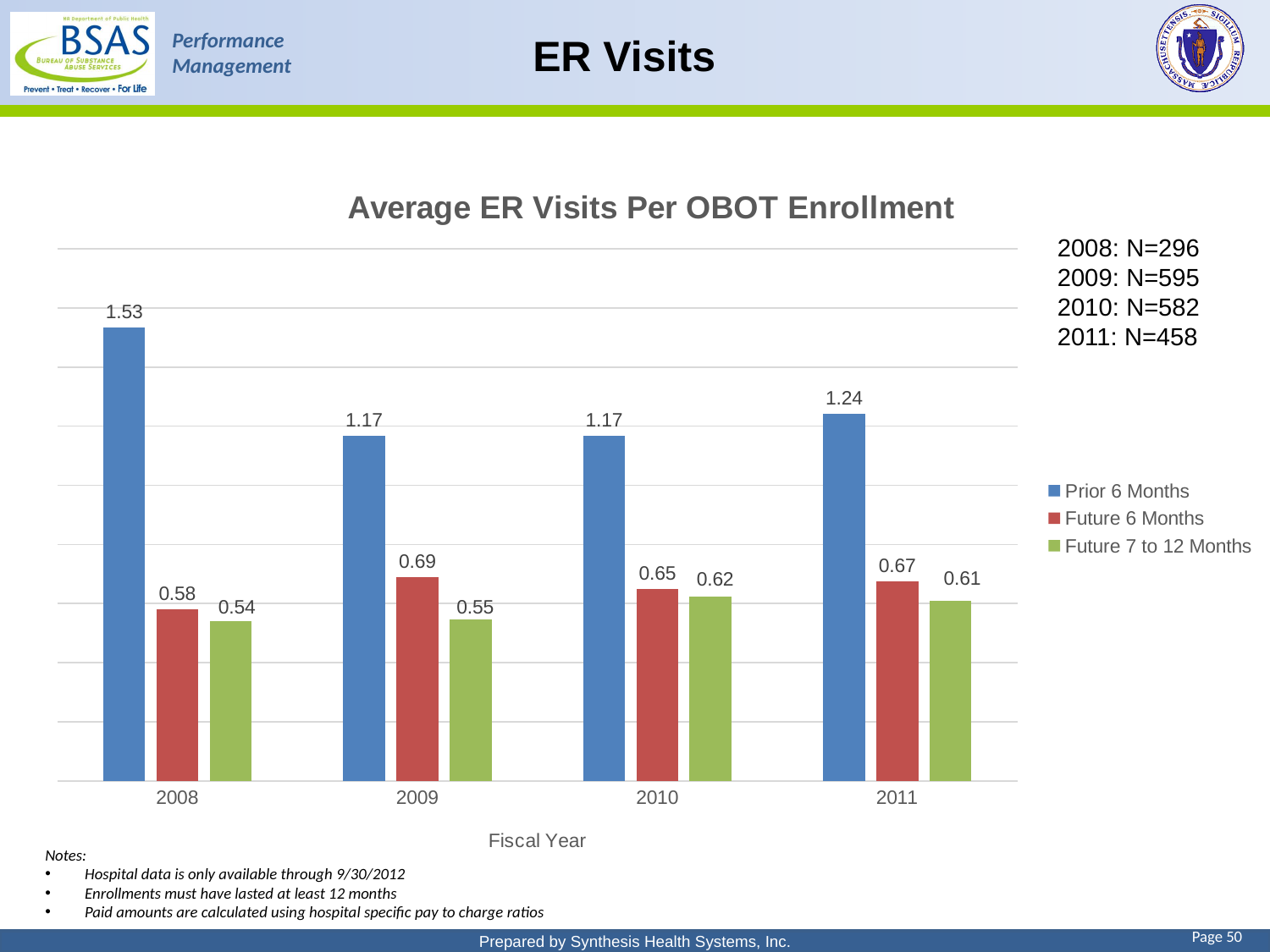
What is the Future 7 to 12 Months value for fiscal year 2010? 0.62 Which fiscal year has the highest Prior 6 Months value? 2008 What is the Prior 6 Months value for fiscal year 2011? 1.24 Which is larger for fiscal year 2011: the Future 6 Months value or the Future 7 to 12 Months value? Future 6 Months What kind of chart is shown on the slide? Bar chart What is the title of the chart? Average ER Visits Per OBOT Enrollment How many fiscal years are shown on the x axis? 4 Which fiscal year has the lowest Future 7 to 12 Months value? 2008 How many series does the legend list? 3 What is the Future 6 Months value for fiscal year 2009? 0.69 What is the Prior 6 Months value for fiscal year 2008? 1.53 What is the difference between the Prior 6 Months and Future 6 Months values for fiscal year 2008? 0.95